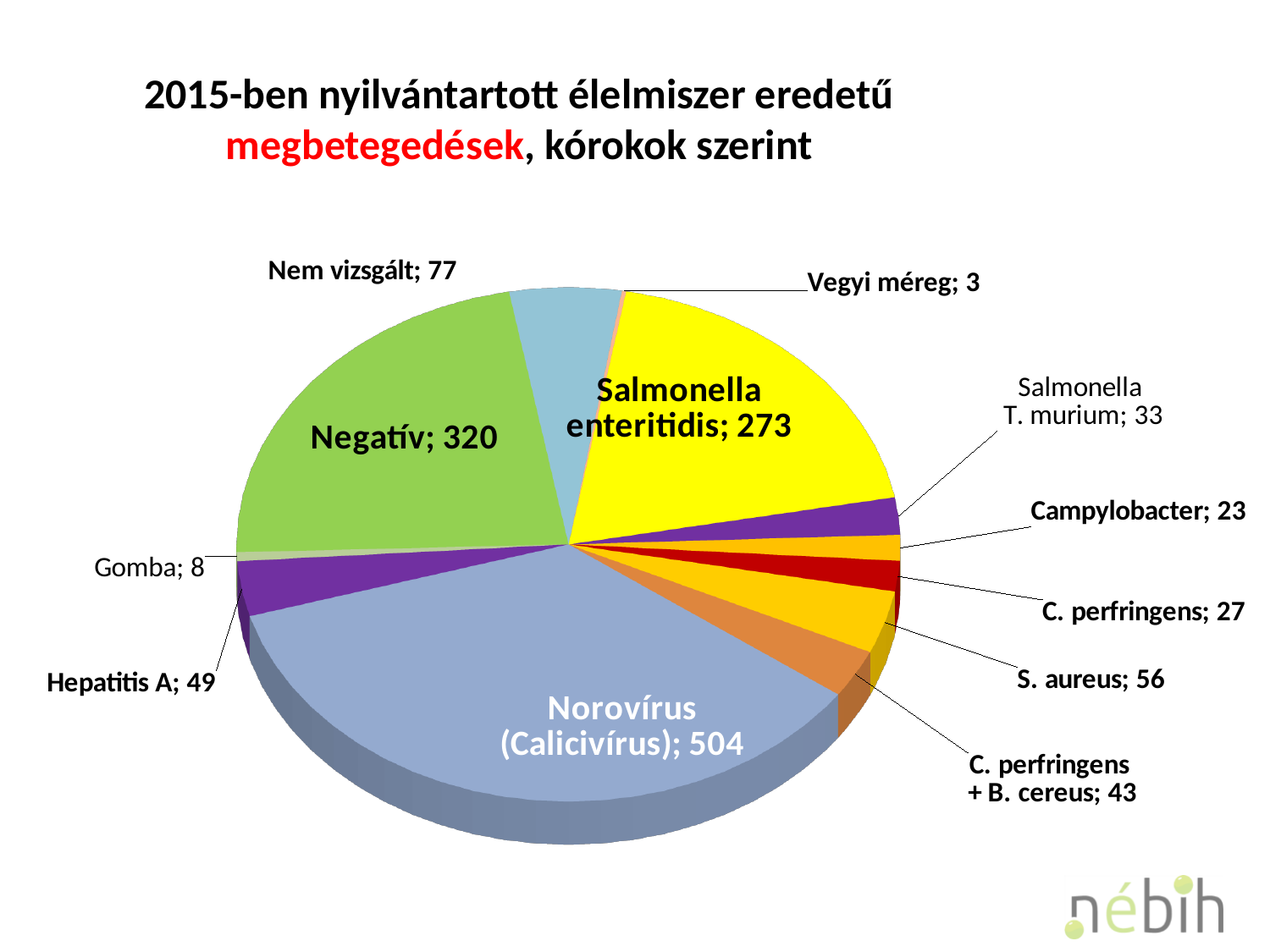
What is the value for Hepatitis A? 49 Which is larger, the value for Campylobacter or the value for Salmonella T. murium? Salmonella T. murium What is the title of the chart on the slide? 2015-ben nyilvántartott élelmiszer eredetű megbetegedések, kórokok szerint What is the difference between the values for Norovírus (Calicivírus) and Negatív? 184 What is the value for Norovírus (Calicivírus)? 504 Which category has the largest slice of the pie? Norovírus (Calicivírus) What is the difference between the values for S. aureus and C. perfringens? 29 Which category has the smallest value? Vegyi méreg What is the value for Salmonella enteritidis? 273 What kind of chart is shown on the slide? pie chart What is the value for Nem vizsgált? 77 How many categories (slices) does the pie chart show? 12